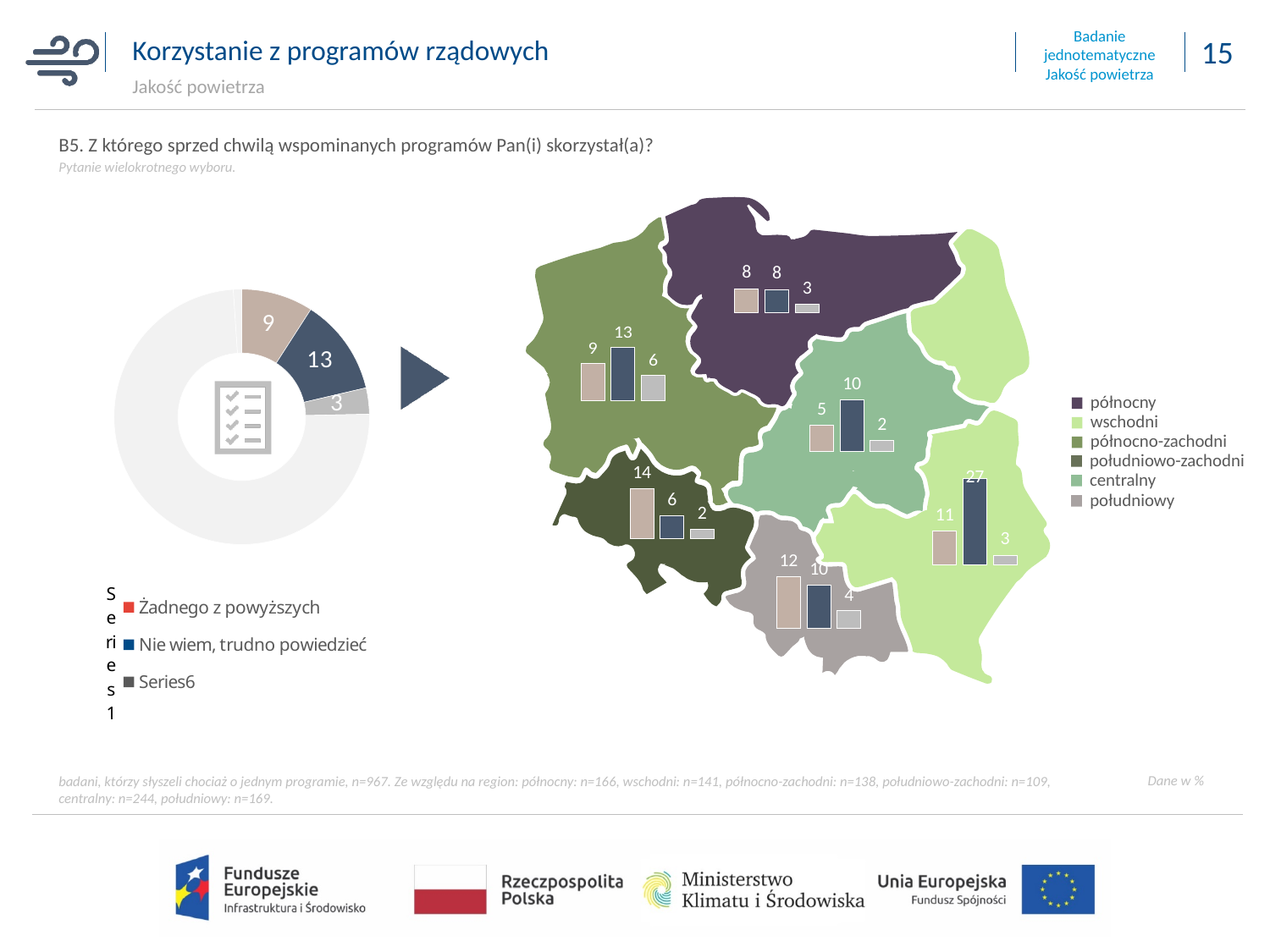
On the map chart, in the południowo-zachodni region, which is larger: the beige bar or the dark blue bar? The beige bar (14) In the donut chart on the left, what value is shown on the dark blue segment? 13 On the map chart, what is the value of the beige bar in the południowo-zachodni (south-western) region? 14 On the map chart, what is the value of the dark blue bar in the wschodni (eastern) region? 27 On the map chart, which region has the lowest beige bar? centralny (5) How many regions does the legend next to the map list? 6 In the donut chart on the left, which labelled segment has the smallest value? The grey segment (3) What kind of chart is shown on the left side of the slide? Donut (pie) chart On the map chart, which region has the highest dark blue bar? wschodni On the map chart, in the wschodni region, what is the difference between the dark blue bar (27) and the beige bar (11)? 16 In the donut chart on the left, what is the difference between the dark blue segment (13) and the beige segment (9)? 4 In the donut chart on the left, what value is shown on the beige segment? 9